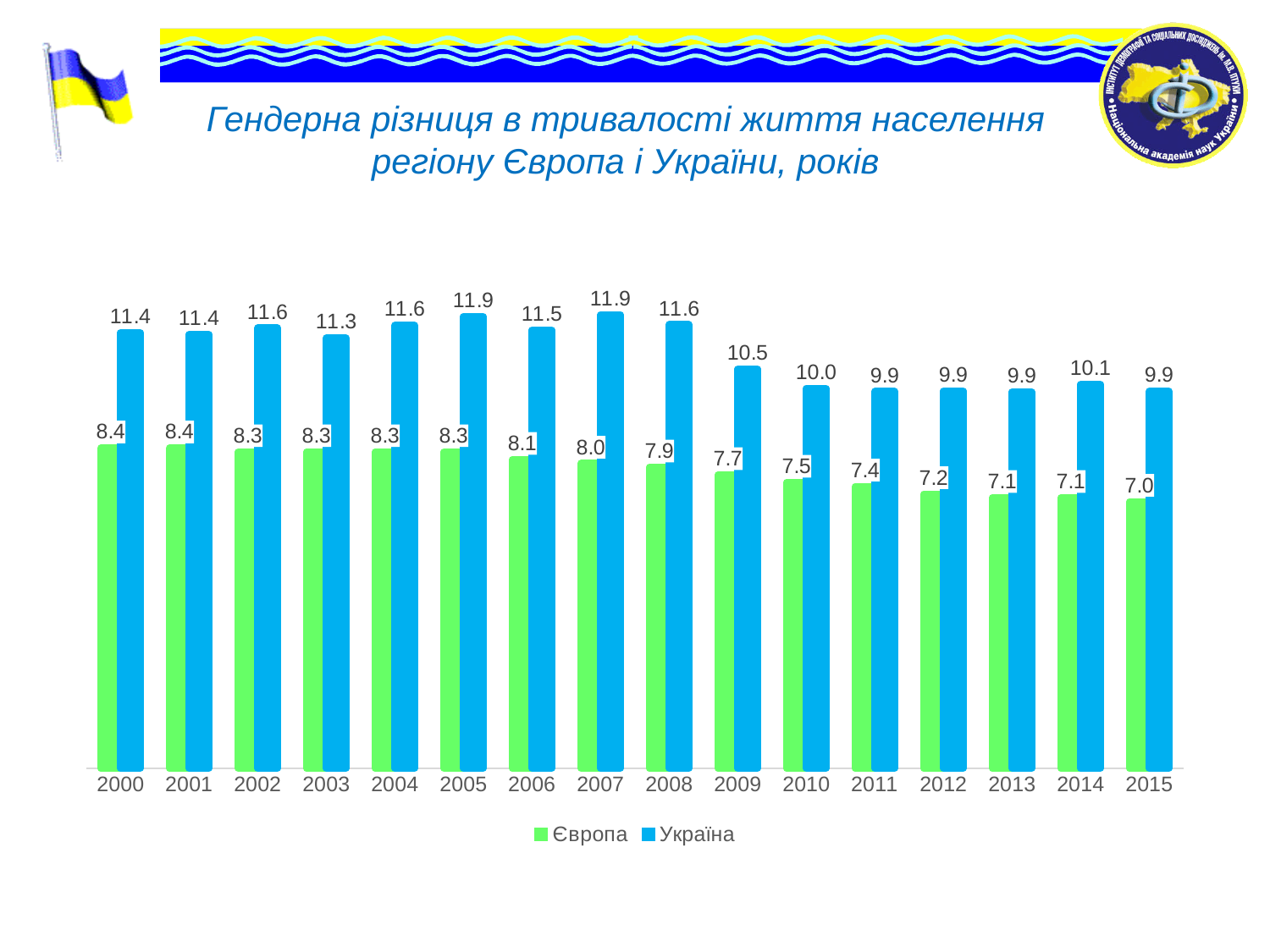
In which year is the value for Європа the lowest? 2015 What is the value for Європа in 2009? 7.7 Do the values for Європа rise or fall from 2000 to 2015? fall What is the value for Європа in 2012? 7.2 What is the value for Україна in 2014? 10.1 What is the difference between the Україна and Європа values in 2000? 3.0 Which is larger: the Україна value in 2007 or in 2008? 2007 How many series does the legend list? 2 What is the value for Україна in 2005? 11.9 What is the difference between the Україна and Європа values in 2015? 2.9 What kind of chart is shown on the slide? bar chart How many years are shown on the x axis? 16